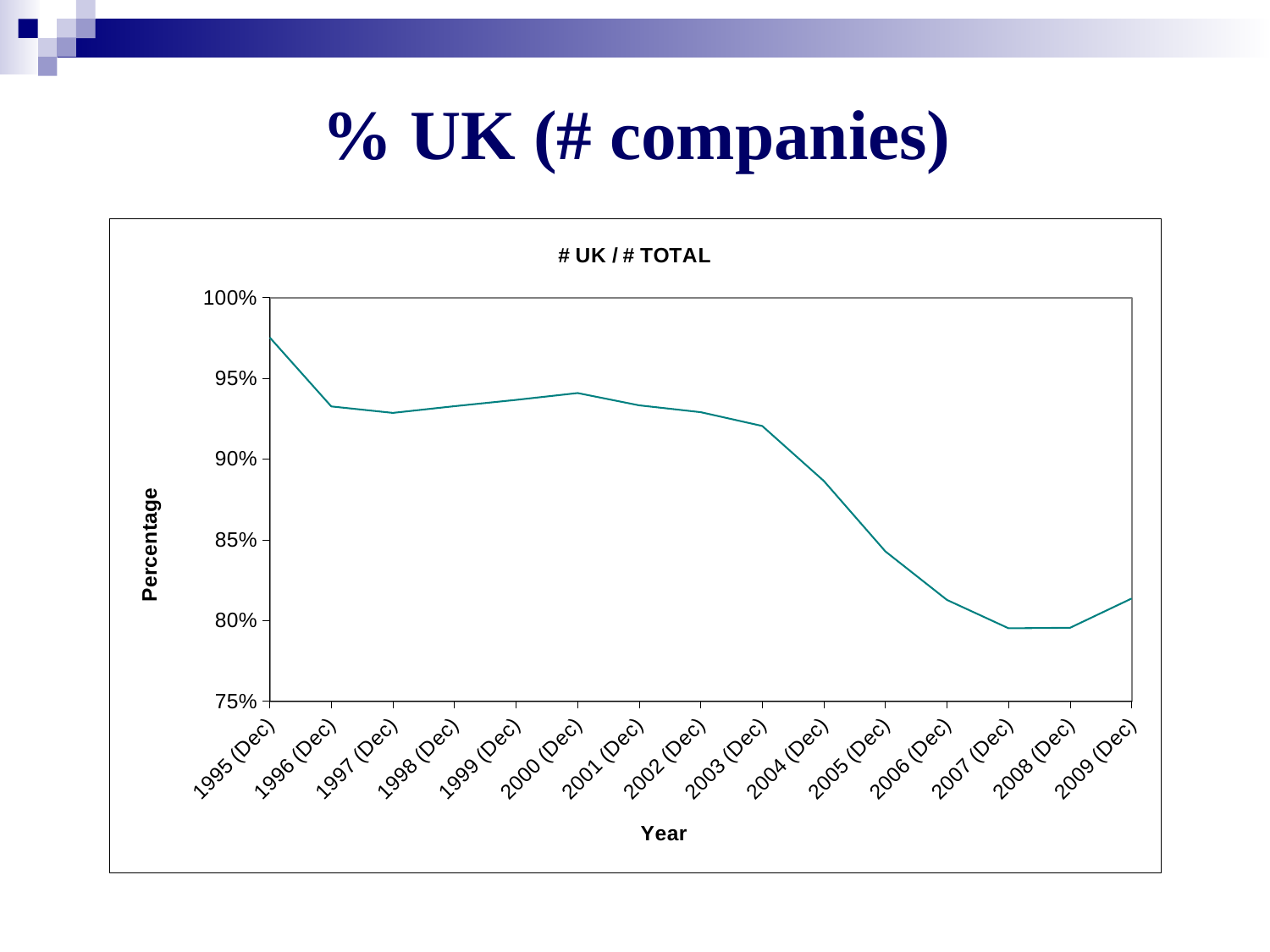
What is the title printed above the plot area of the chart? # UK / # TOTAL Is the value for 1995 (Dec) greater or less than 95%? greater Overall, does the percentage rise or fall from 1995 (Dec) to 2009 (Dec)? fall How many data points (years) are plotted on the chart? 15 Is the value for 2000 (Dec) greater or less than 90%? greater Which is larger, the value for 2003 (Dec) or the value for 2005 (Dec)? 2003 (Dec) Is the value for 2004 (Dec) greater or less than 90%? less Which year has the highest value on the chart? 1995 (Dec) What is the label on the vertical axis of the chart? Percentage What kind of chart is shown on the slide? line chart